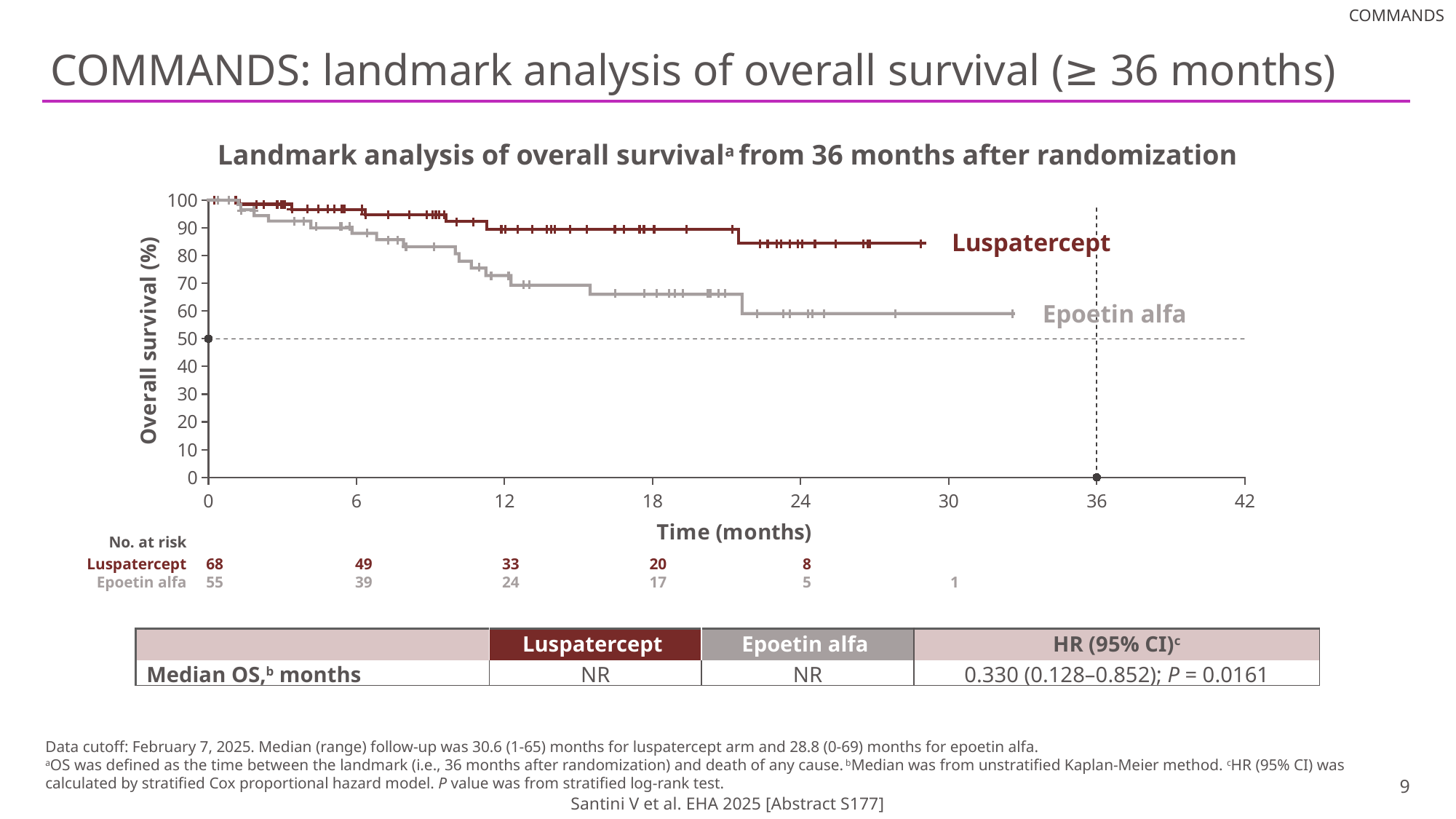
What is the difference between the number at risk for Luspatercept and Epoetin alfa at 0 months? 13 What kind of chart is shown on the slide? line chart (Kaplan-Meier survival curve) What is the title of the x axis of the chart? Time (months) How many treatment arms (series) are plotted on the chart? 2 At 18 months, which arm has more patients at risk, Luspatercept or Epoetin alfa? Luspatercept What is the number at risk for Luspatercept at 0 months? 68 Which curve is higher at 18 months, Luspatercept or Epoetin alfa? Luspatercept What is the number at risk for Epoetin alfa at 12 months? 24 Do the survival curves rise or fall as time increases along the x axis? fall What is the number at risk for Epoetin alfa at 30 months? 1 Is the overall survival for Luspatercept at 24 months greater or less than 80%? greater Is the overall survival for Epoetin alfa at 24 months greater or less than 70%? less